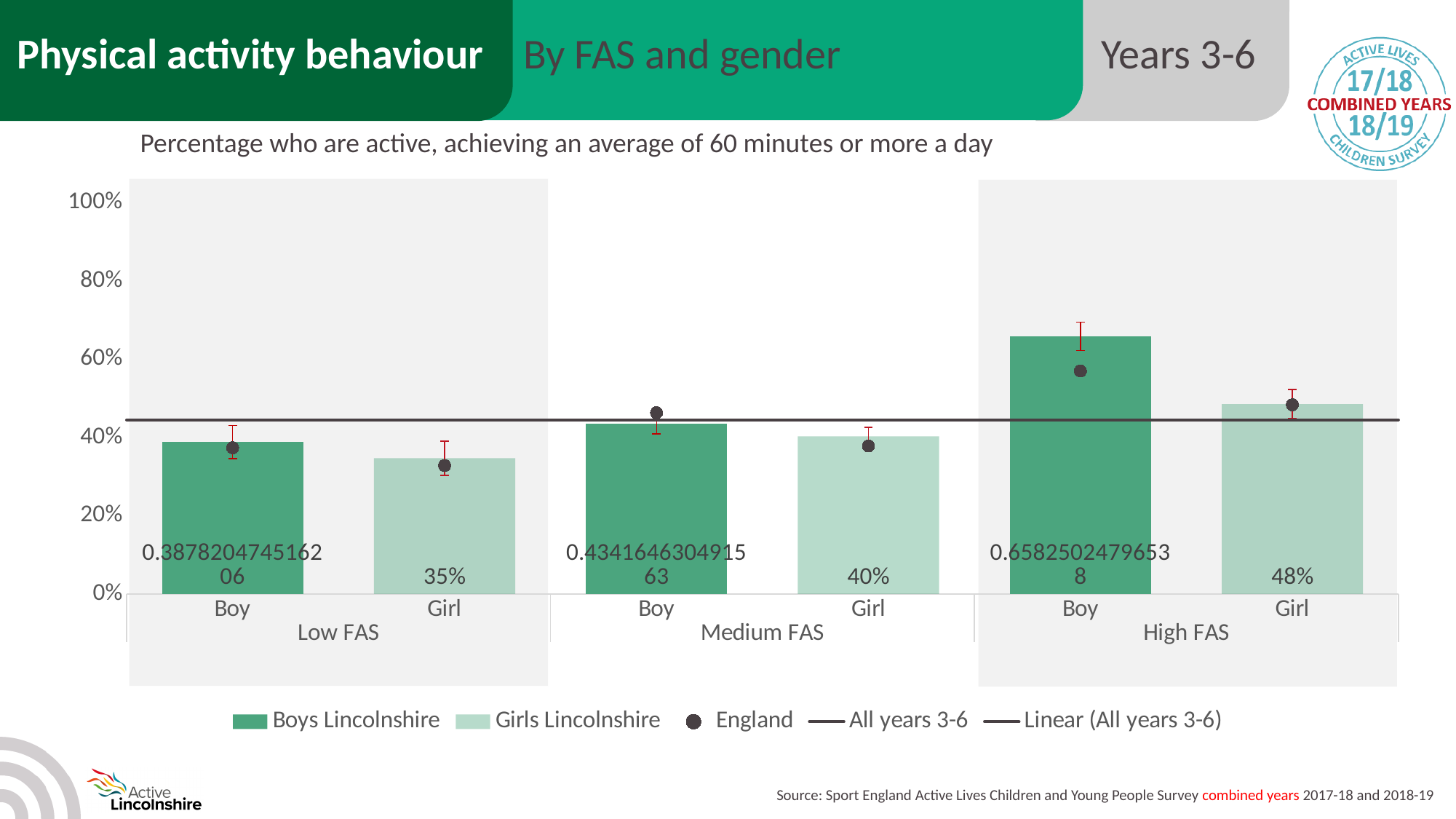
What is the difference between the Girl values for High FAS and Low FAS? 13% How many entries does the legend list? 5 How many bars are plotted in the chart? 6 Is the value for Boy in the High FAS group greater or less than 60%? greater What is the value for Girl in the Low FAS group? 35% Which bar has the lowest value? Girl, Low FAS What kind of chart is shown on the slide? Bar chart What is the value for Girl in the Medium FAS group? 40% What data label is printed on the Boy bar in the Low FAS group? 0.387820474516206 What is the value for Girl in the High FAS group? 48% Which bar has the highest value? Boy, High FAS Which is larger, the Girl value for Medium FAS or the Girl value for High FAS? Girl, High FAS